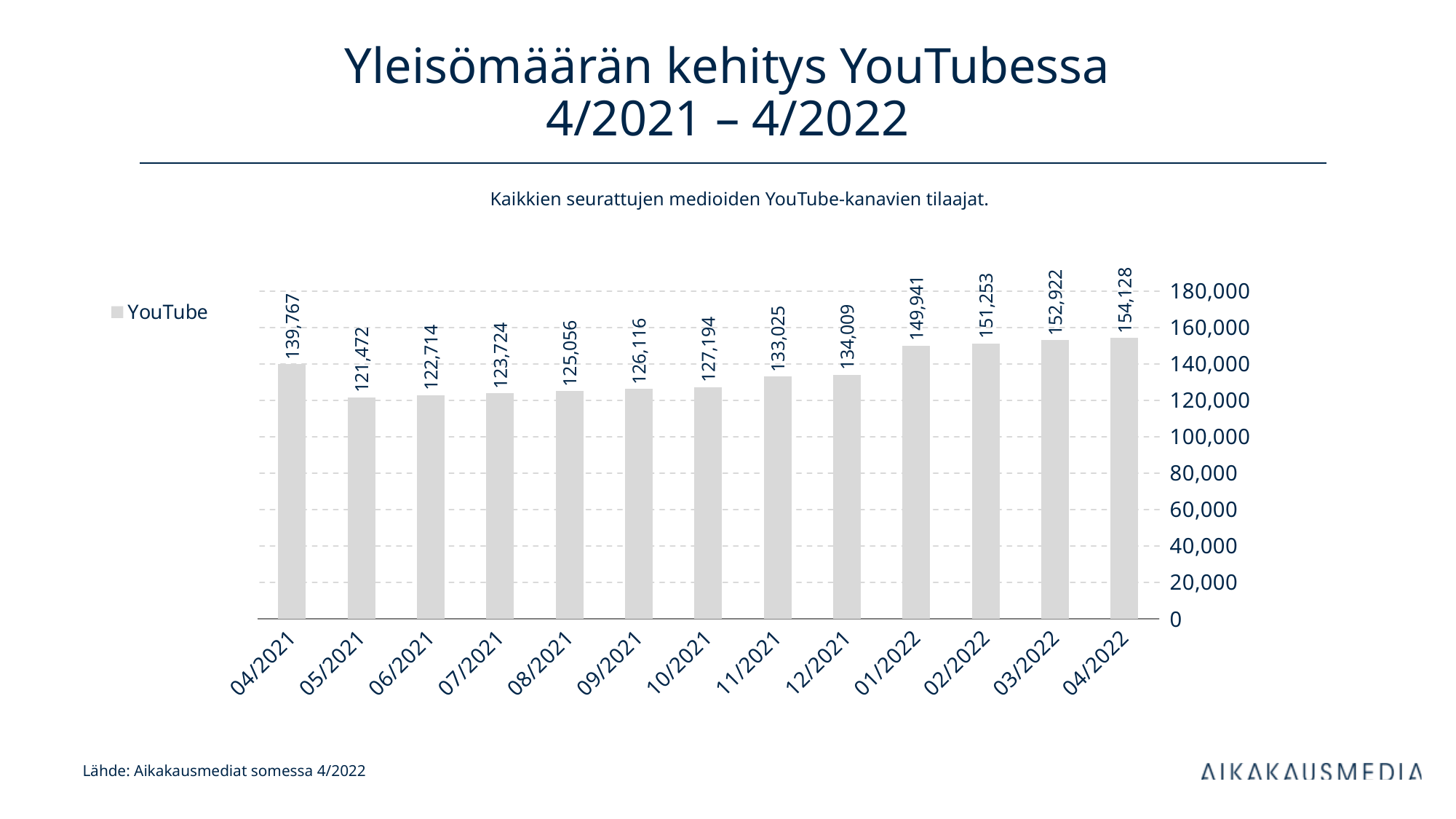
What is the difference between the values for 12/2021 and 11/2021? 984 What series does the legend list? YouTube Which is larger, the value for 04/2021 or the value for 12/2021? 04/2021 Which month has the highest value? 04/2022 Which month has the lowest value? 05/2021 What is the value for 04/2021? 139,767 What is the value for 09/2021? 126,116 How many months are shown on the x axis? 13 What is the value for 01/2022? 149,941 What kind of chart is shown on the slide? bar chart What is the difference between the values for 04/2022 and 04/2021? 14,361 Is the value for 03/2022 greater or less than 140,000? greater